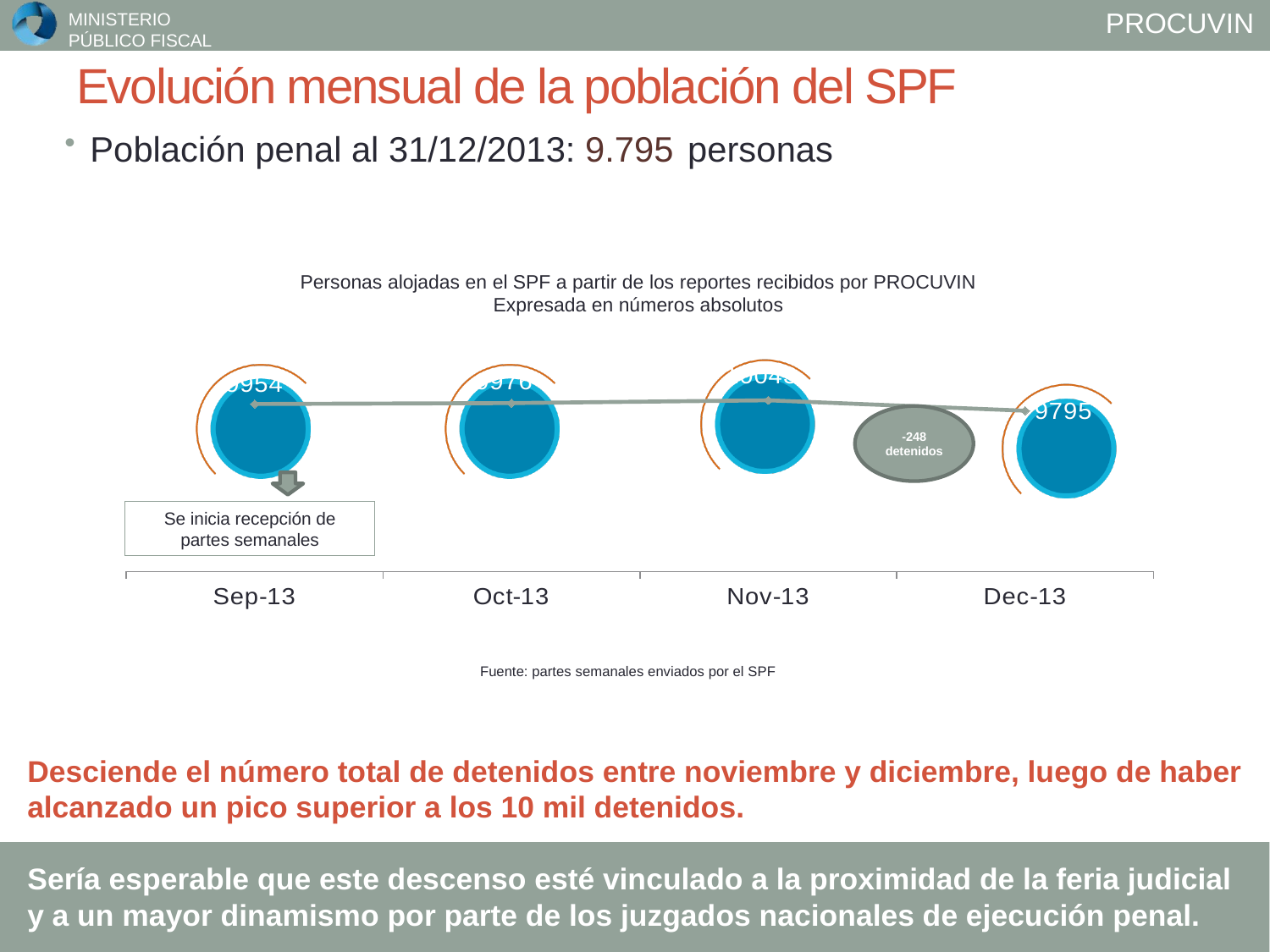
What is the title of the chart? Personas alojadas en el SPF a partir de los reportes recibidos por PROCUVIN Expresada en números absolutos What is the value plotted for Dec-13? 9795 What does the annotation box under the Sep-13 point say? Se inicia recepción de partes semanales Which is larger, the value for Nov-13 or the value for Dec-13? Nov-13 Which month has the highest plotted value? Nov-13 What kind of chart is shown on the slide? Line chart According to the annotation on the chart, by how many detainees did the number fall between Nov-13 and Dec-13? 248 Does the plotted value rise or fall between Nov-13 and Dec-13? Fall What is the first month shown on the x axis of the chart? Sep-13 Which month has the lowest plotted value? Dec-13 How many monthly data points are plotted on the chart? 4